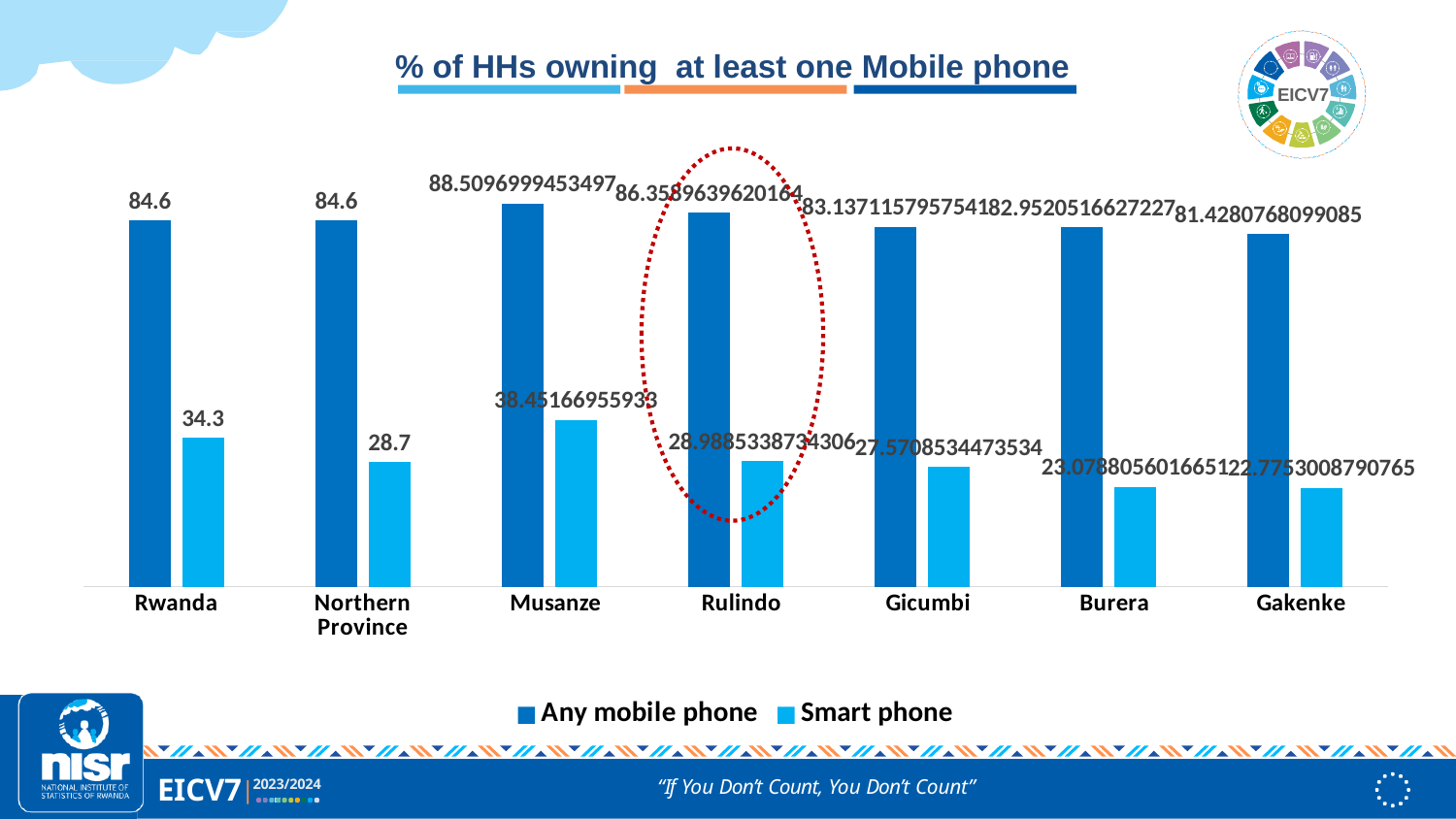
How many categories are shown on the x axis? 7 Which category has the highest value for Any mobile phone? Musanze Which is larger, the Smart phone value for Musanze or for Gicumbi? Musanze What is the value for Any mobile phone in Rwanda? 84.6 What is the difference between the Smart phone values for Rwanda and Northern Province? 5.6 What is the difference between the Any mobile phone and Smart phone values for Rwanda? 50.3 What is the value for Smart phone in Northern Province? 28.7 What is the value for Smart phone in Rwanda? 34.3 How many series does the legend list? 2 What is the value for Any mobile phone in Musanze? 88.5096999453497 Which category has the highest value for Smart phone? Musanze What is the value for Any mobile phone in Gakenke? 81.4280768099085